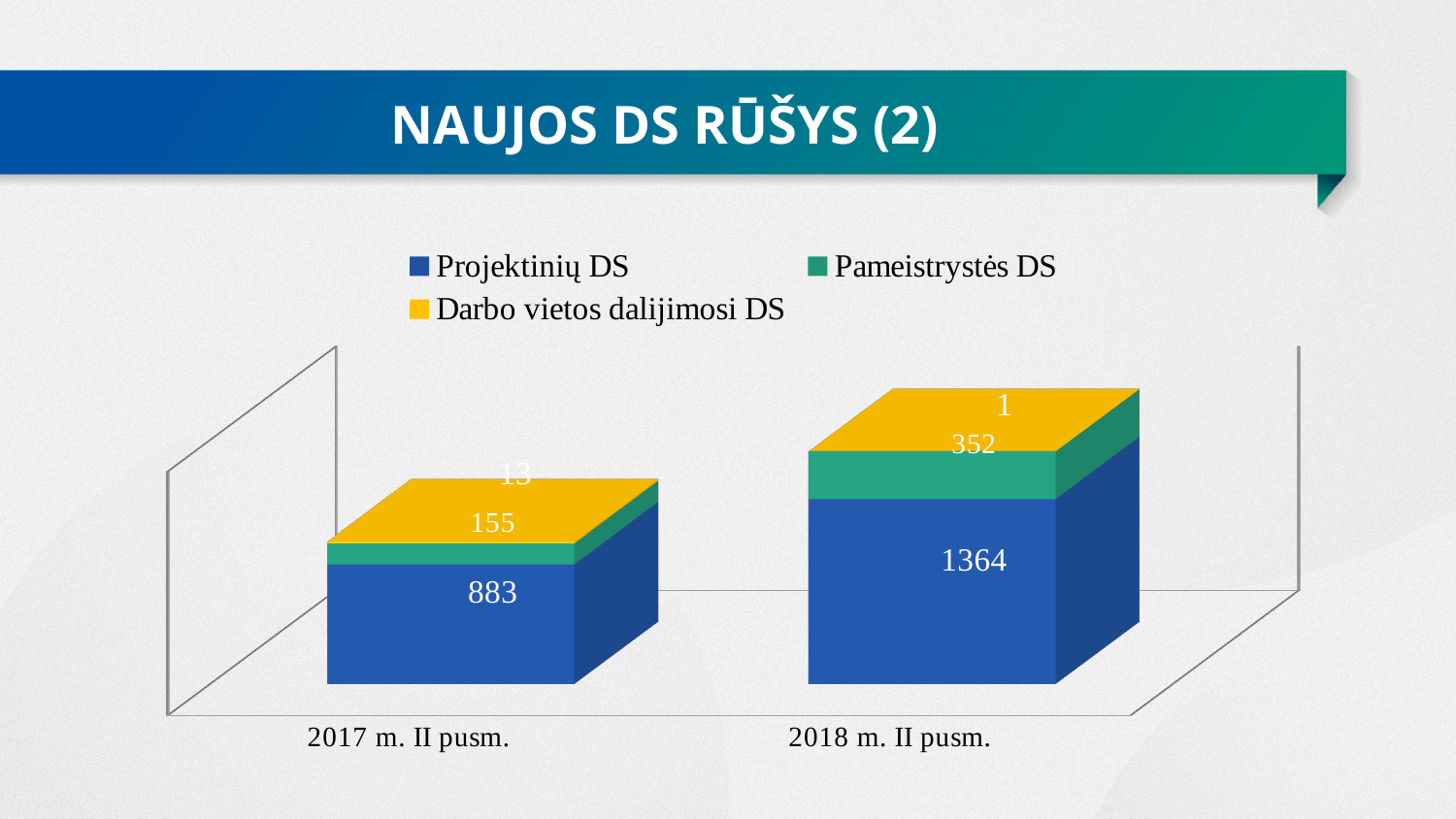
How many categories are shown on the x axis? 2 What kind of chart is shown on the slide? stacked bar chart What is the value of Projektinių DS for 2017 m. II pusm.? 883 Which category has the higher value for Pameistrystės DS, 2017 m. II pusm. or 2018 m. II pusm.? 2018 m. II pusm. What is the total of the stacked bar for 2018 m. II pusm.? 1717 What is the value of Pameistrystės DS for 2018 m. II pusm.? 352 What is the value of Projektinių DS for 2018 m. II pusm.? 1364 How many series does the legend list? 3 What is the value of Pameistrystės DS for 2017 m. II pusm.? 155 What is the difference in Projektinių DS between 2018 m. II pusm. and 2017 m. II pusm.? 481 Which series is shown in yellow in the legend? Darbo vietos dalijimosi DS What is the value of Darbo vietos dalijimosi DS for 2018 m. II pusm.? 1